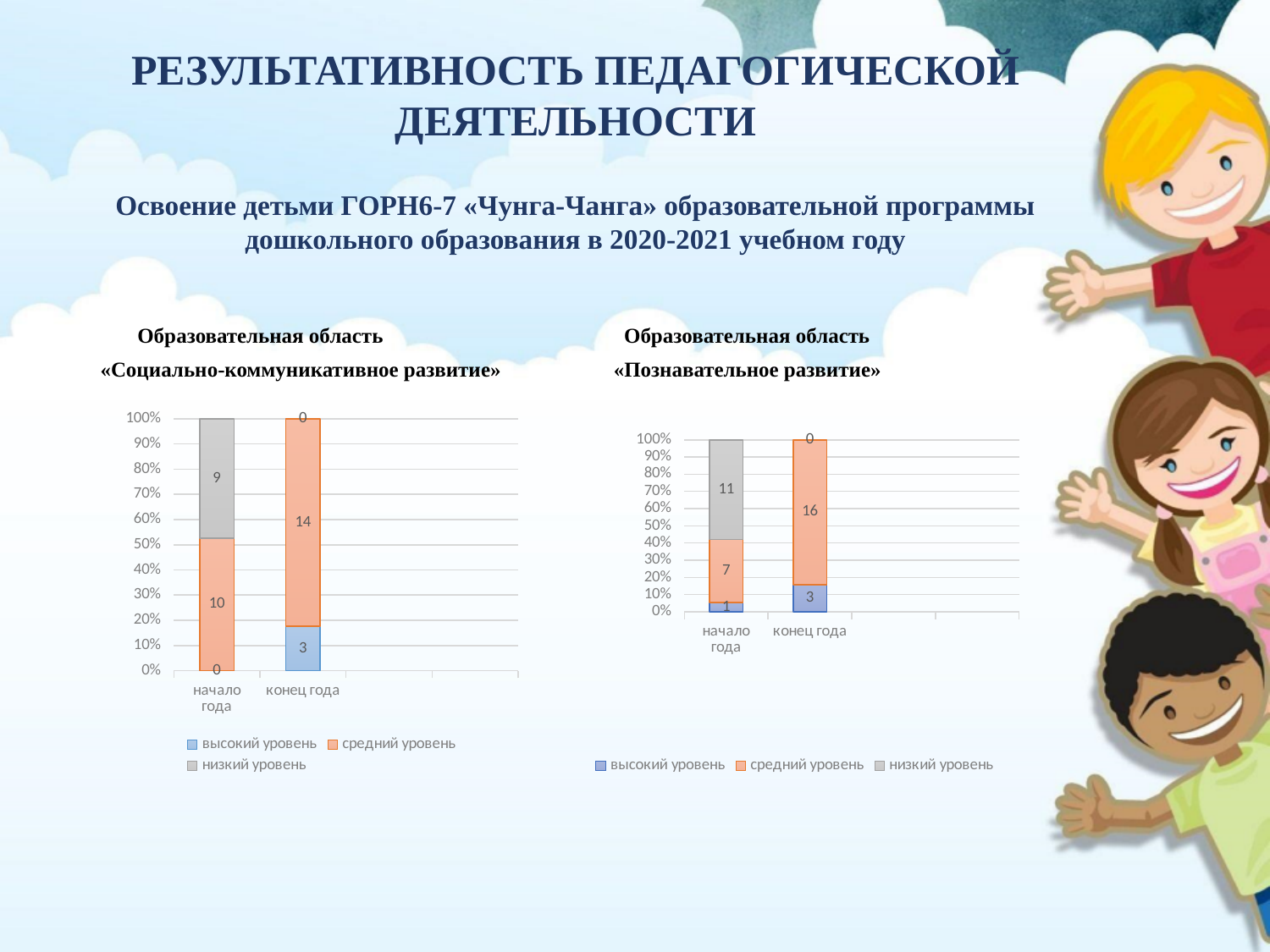
In the «Познавательное развитие» chart, how many series does the legend list? 3 In the «Социально-коммуникативное развитие» chart, what is the value for низкий уровень at начало года? 9 How many categories are shown on the x axis of the «Социально-коммуникативное развитие» chart? 2 What kind of chart is the «Познавательное развитие» chart? stacked bar chart In the «Познавательное развитие» chart, what is the value for высокий уровень at начало года? 1 In the «Социально-коммуникативное развитие» chart, what is the total of the stacked bar for конец года? 17 In the «Социально-коммуникативное развитие» chart, what is the value for средний уровень at конец года? 14 In the «Познавательное развитие» chart, what is the total of the stacked bar for начало года? 19 In the «Социально-коммуникативное развитие» chart, what is the difference between средний уровень at конец года and at начало года? 4 In the «Познавательное развитие» chart, which is larger: низкий уровень at начало года or средний уровень at начало года? низкий уровень at начало года In the «Познавательное развитие» chart, what is the value for средний уровень at конец года? 16 In the «Социально-коммуникативное развитие» chart, which legend entry is shown in grey? низкий уровень